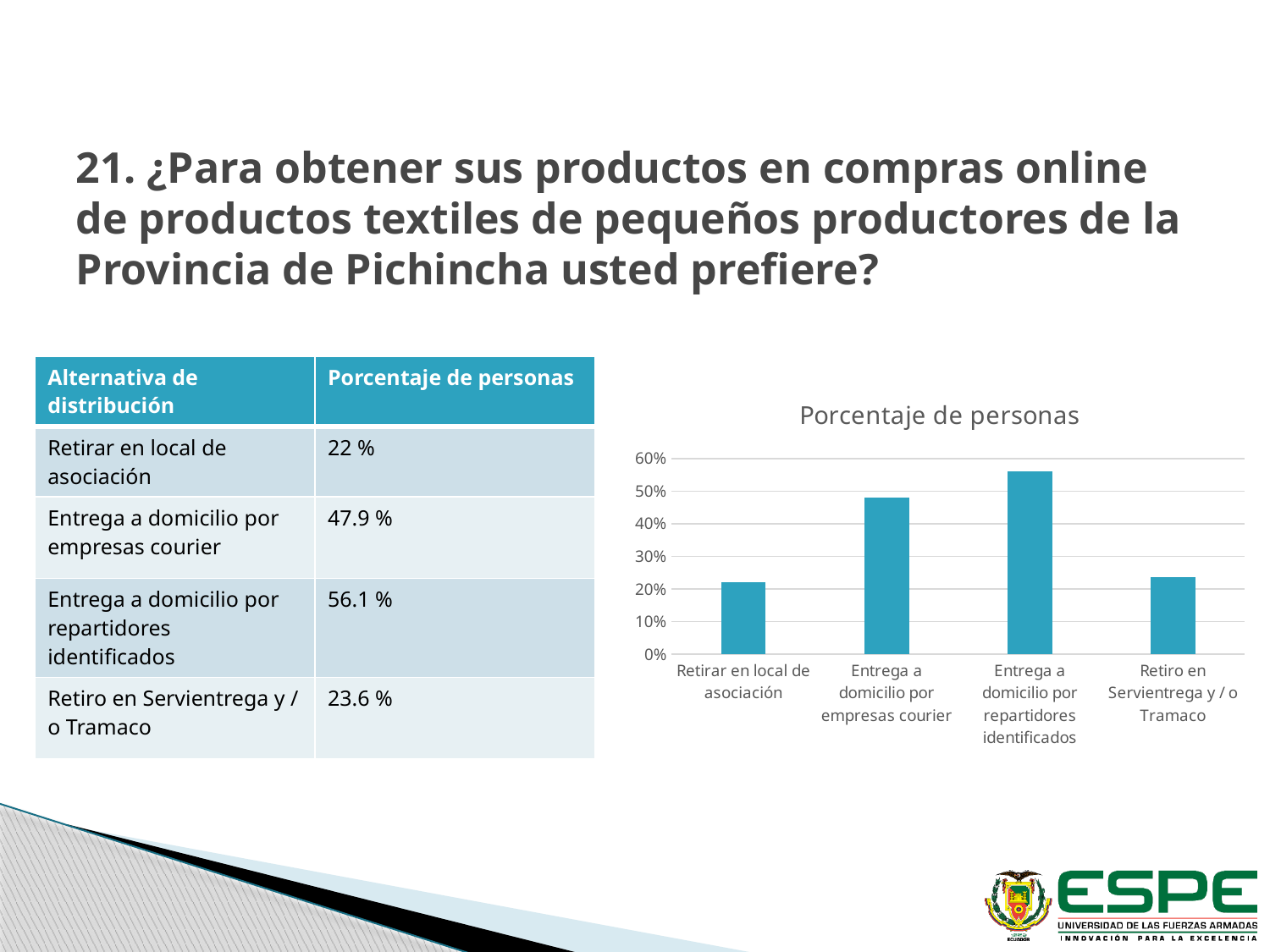
According to the slide, what is the percentage for 'Entrega a domicilio por repartidores identificados'? 56.1 % What is the difference between the percentages for 'Entrega a domicilio por repartidores identificados' and 'Retirar en local de asociación'? 34.1 % How many categories are plotted in the chart? 4 Is the value for 'Entrega a domicilio por repartidores identificados' greater or less than 50%? greater Is the value for 'Retirar en local de asociación' greater or less than 30%? less What type of chart is shown on the slide? bar chart According to the slide, what is the percentage for 'Retiro en Servientrega y / o Tramaco'? 23.6 % According to the slide, what is the percentage for 'Entrega a domicilio por empresas courier'? 47.9 % Which category has the highest value in the chart? Entrega a domicilio por repartidores identificados Which category has the lowest value in the chart? Retirar en local de asociación Which is larger: the value for 'Entrega a domicilio por empresas courier' or the value for 'Retiro en Servientrega y / o Tramaco'? Entrega a domicilio por empresas courier What is the title of the chart? Porcentaje de personas